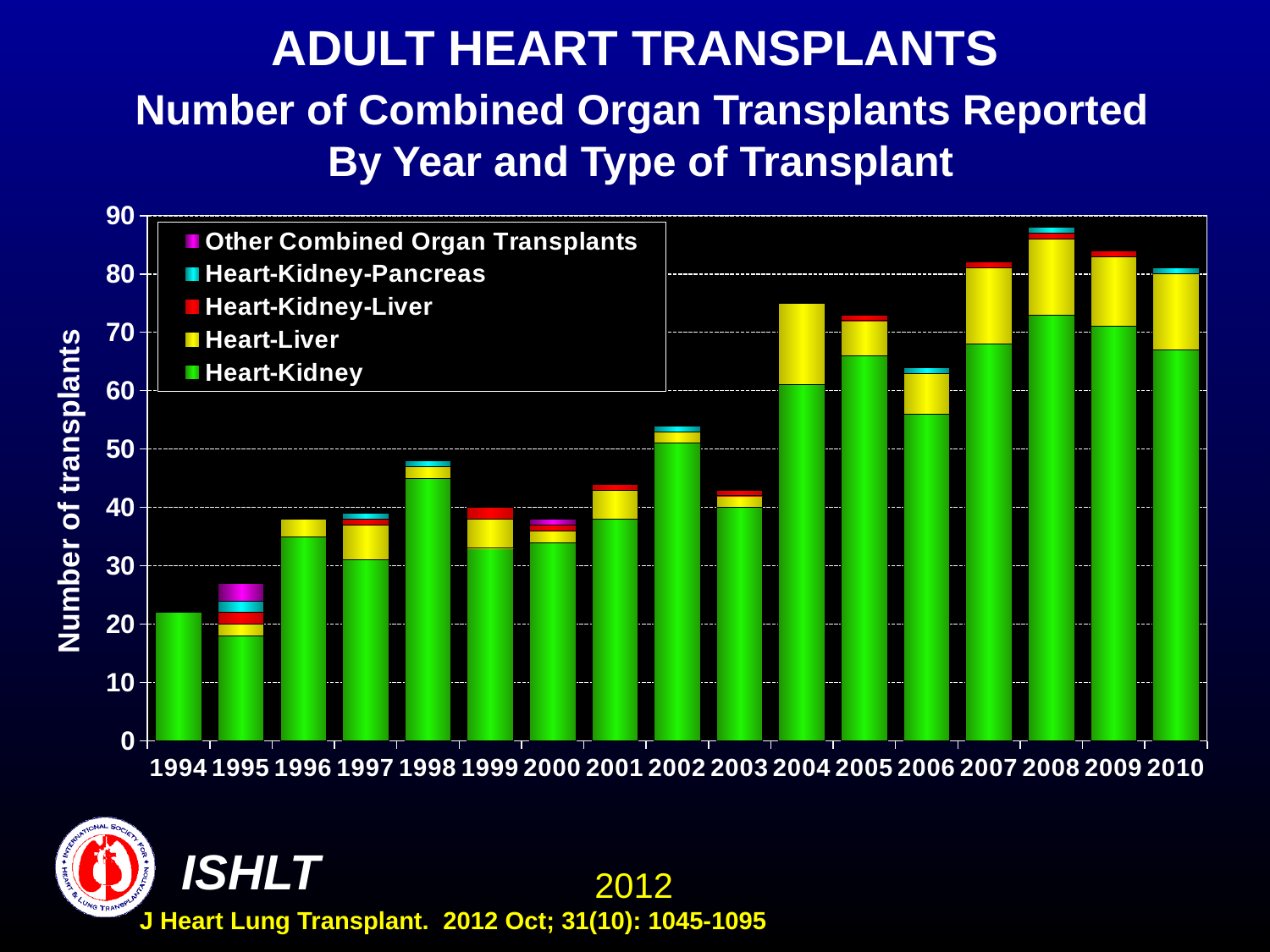
Which year has the lowest total number of combined organ transplants? 1994 Overall, do the total numbers of combined organ transplants rise or fall from 1994 to 2010? rise Is the total number of transplants for 1994 greater or less than 30? less Is the total number of transplants for 1996 greater or less than 40? less How many series does the legend list? 5 Which year has the highest total number of combined organ transplants? 2008 Which series is shown in green at the bottom of each bar? Heart-Kidney Which year has a larger total number of transplants, 2002 or 2003? 2002 How many years are shown along the x axis? 17 What kind of chart is shown on the slide? Stacked bar chart Is the total number of transplants for 2004 greater or less than 70? greater